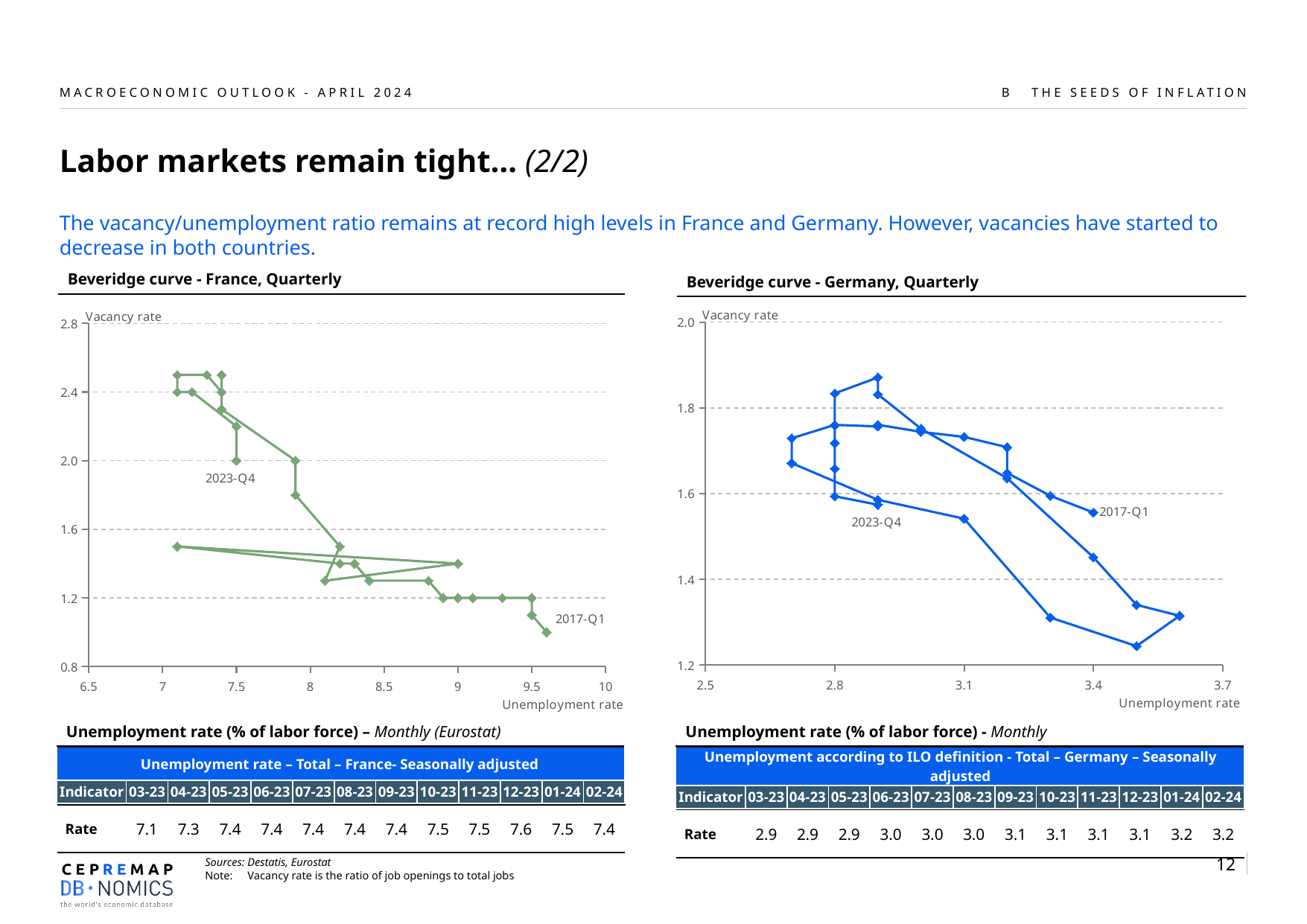
In the Beveridge curve - France, Quarterly chart, which point has the higher vacancy rate, 2017-Q1 or 2023-Q4? 2023-Q4 What type of chart is the Beveridge curve - France, Quarterly chart? line chart In the Beveridge curve - Germany, Quarterly chart, is the unemployment rate at the 2017-Q1 point greater or less than 3.1? greater In the Beveridge curve - Germany, Quarterly chart, which point has the higher unemployment rate, 2017-Q1 or 2023-Q4? 2017-Q1 In the Beveridge curve - France, Quarterly chart, does the vacancy rate generally rise or fall as the unemployment rate increases along the x axis? fall In the Beveridge curve - France, Quarterly chart, what is the label of the vertical axis? Vacancy rate In the Beveridge curve - France, Quarterly chart, is the vacancy rate at the 2023-Q4 point greater or less than 1.6? greater In the Beveridge curve - Germany, Quarterly chart, is the unemployment rate at the 2023-Q4 point greater or less than 3.1? less In the Beveridge curve - Germany, Quarterly chart, what is the label of the horizontal axis? Unemployment rate